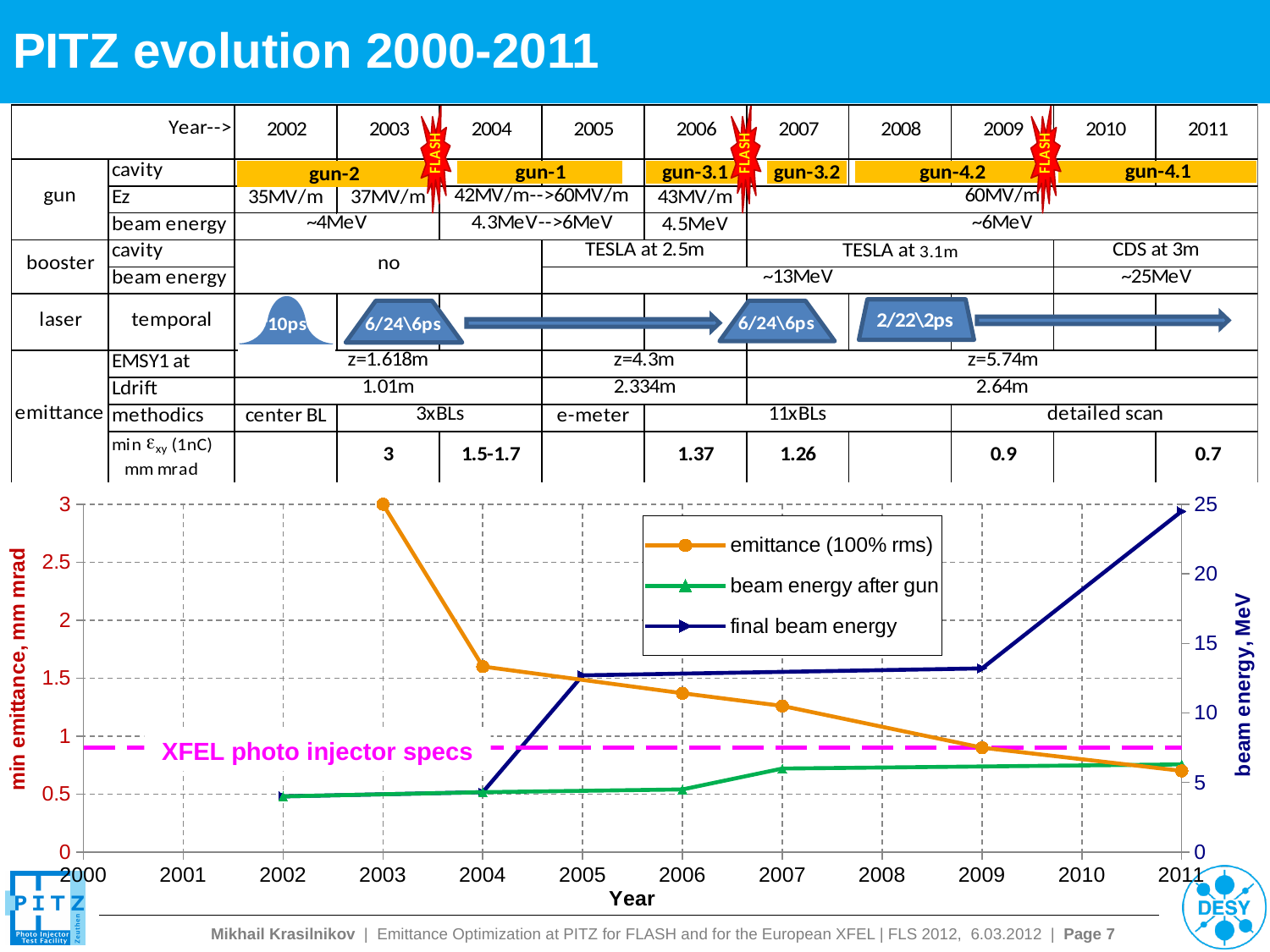
Is the emittance (100% rms) in 2004 greater or less than 2 mm mrad? less Which is larger, the emittance (100% rms) in 2003 or in 2009? 2003 In which year is the emittance (100% rms) highest? 2003 Does the emittance (100% rms) rise or fall from 2003 to 2011? fall In which year is the emittance (100% rms) lowest? 2011 Is the beam energy after gun in 2002 greater or less than 5 MeV? less Is the final beam energy in 2011 greater or less than 20 MeV? greater Does the final beam energy rise or fall from 2004 to 2011? rise What label is written on the dashed horizontal line in the chart? XFEL photo injector specs What kind of chart is shown at the bottom of the slide? line chart How many series does the chart legend list? 3 What is the emittance (100% rms) value plotted for 2003? 3